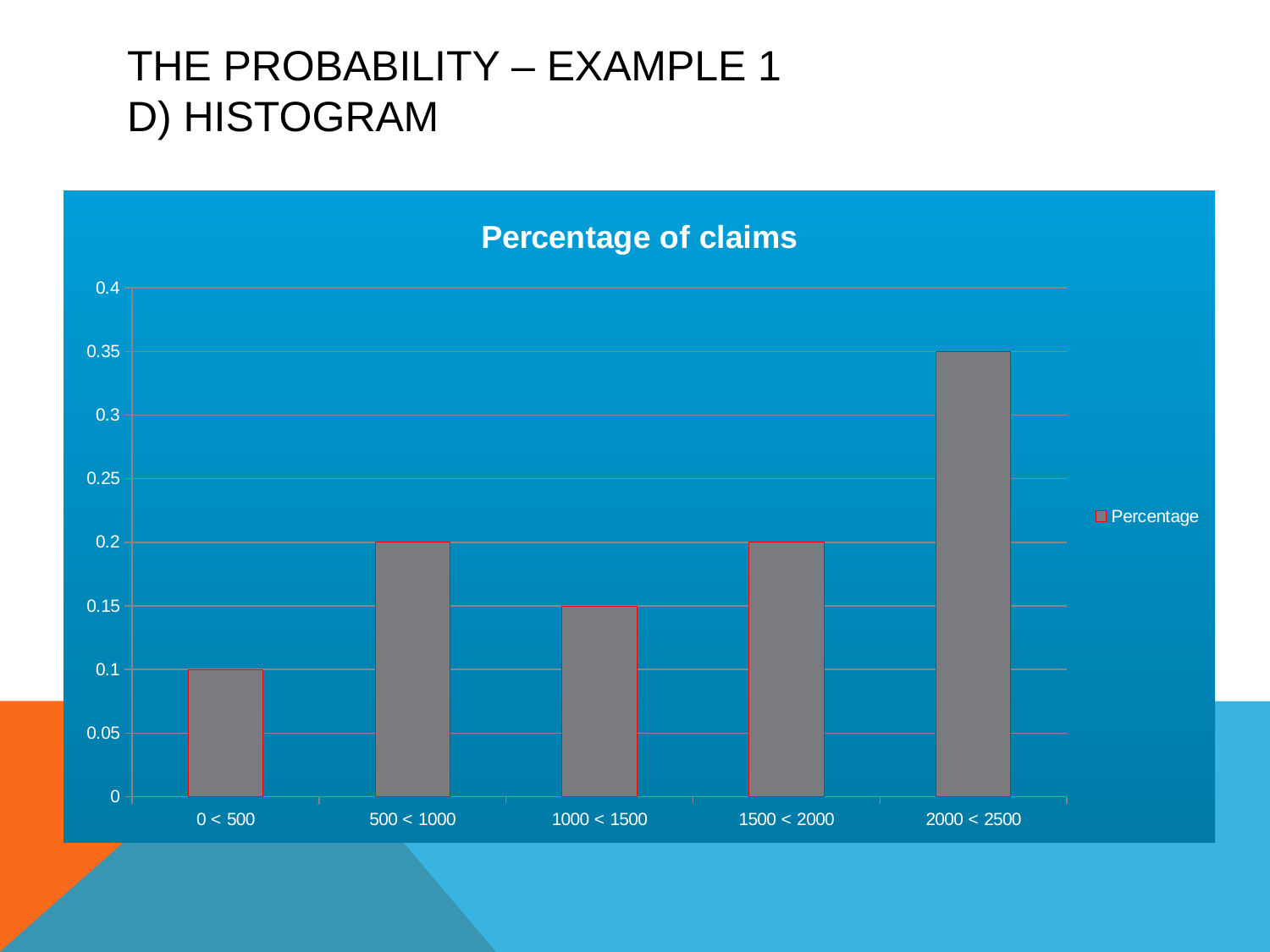
What is the title of the chart? Percentage of claims Which is larger, the value for 500 < 1000 or the value for 1000 < 1500? 500 < 1000 What is the value for the 1000 < 1500 category? 0.15 What is the value for the 0 < 500 category? 0.1 What is the value for the 2000 < 2500 category? 0.35 What is the difference between the values for 2000 < 2500 and 0 < 500? 0.25 Which category has the highest value? 2000 < 2500 How many categories are shown on the x axis? 5 How many series does the legend list? 1 Is the value for 2000 < 2500 greater or less than 0.3? greater What kind of chart is shown on the slide? bar chart Which category has the lowest value? 0 < 500